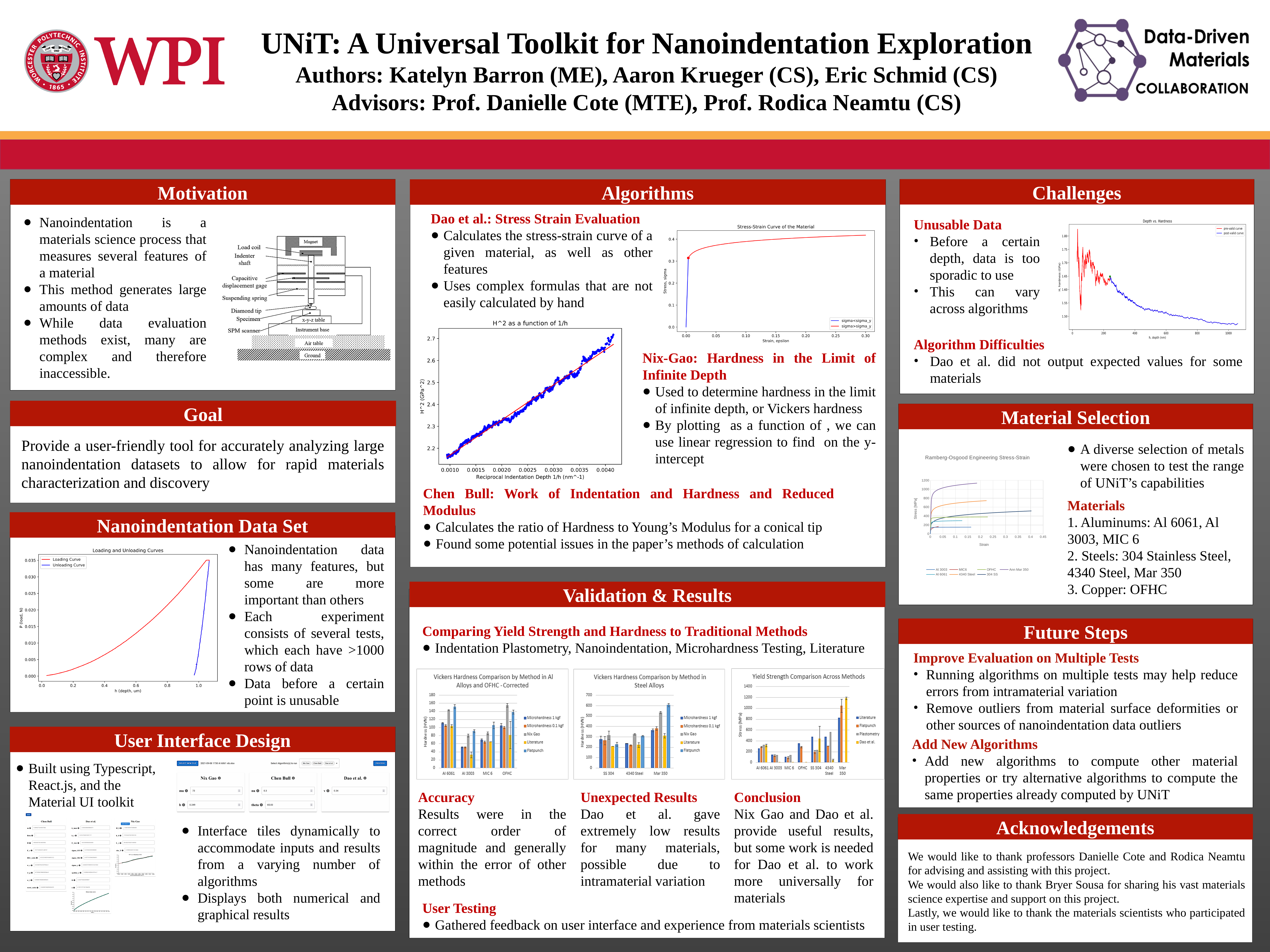
In the "H^2 as a function of 1/h" chart, do the values rise or fall as the reciprocal indentation depth increases? rise How many series does the legend of the "Loading and Unloading Curves" chart list? 2 How many material categories are shown on the x axis of the "Vickers Hardness Comparison by Method in Al Alloys and OFHC - Corrected" chart? 4 What are the two legend entries in the "Depth vs. Hardness" chart in the Challenges section? pre-valid curve, post-valid curve How many series does the legend of the "Yield Strength Comparison Across Methods" chart list? 4 In the "Vickers Hardness Comparison by Method in Steel Alloys" chart, is the Flatpunch value for Mar 350 greater or less than 500? greater How many material categories are shown on the x axis of the "Vickers Hardness Comparison by Method in Steel Alloys" chart? 3 In the "Vickers Hardness Comparison by Method in Al Alloys and OFHC - Corrected" chart, is the Microhardness 1 kgf value for Al 3003 greater or less than 100? less How many material categories are shown on the x axis of the "Yield Strength Comparison Across Methods" chart? 7 In the "Vickers Hardness Comparison by Method in Steel Alloys" chart, which material has the tallest bar? Mar 350 How many series does the legend of the "Vickers Hardness Comparison by Method in Al Alloys and OFHC - Corrected" chart list? 5 What kind of chart is the "Vickers Hardness Comparison by Method in Al Alloys and OFHC - Corrected" chart? bar chart